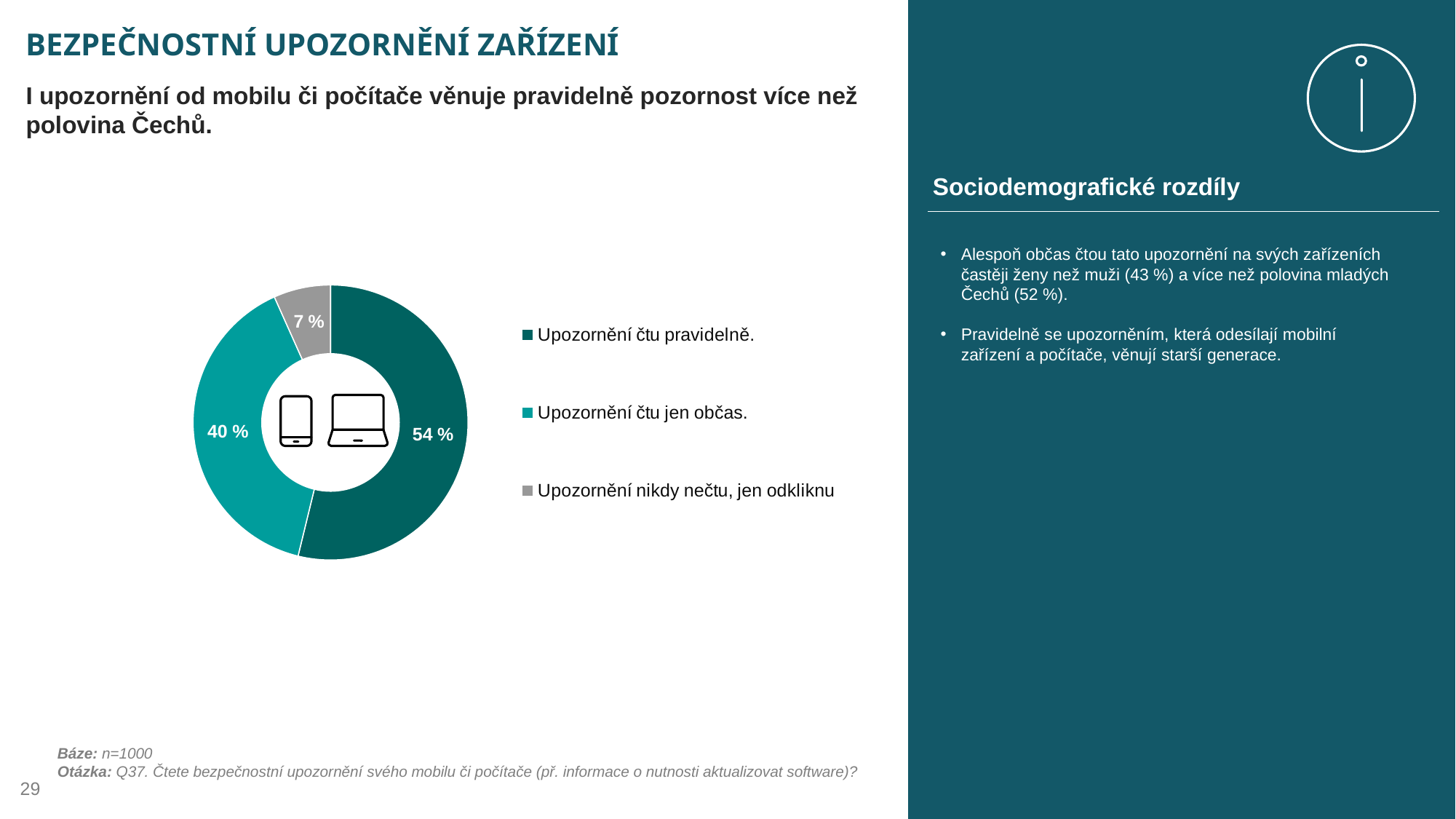
Which category has the smallest slice of the pie? Upozornění nikdy nečtu, jen odkliknu What share of respondents answered "Upozornění nikdy nečtu, jen odkliknu"? 7 % What share of respondents answered "Upozornění čtu jen občas."? 40 % How many slices does the pie chart have? 3 How many entries does the legend list? 3 Which category has the largest slice of the pie? Upozornění čtu pravidelně. What kind of chart is shown on the slide? Pie chart (donut) What is the difference in percentage points between "Upozornění čtu pravidelně." and "Upozornění čtu jen občas."? 14 percentage points What colour is the slice for "Upozornění nikdy nečtu, jen odkliknu"? Grey What is the sample size (base) stated below the chart? n=1000 What share of respondents answered "Upozornění čtu pravidelně."? 54 % Which is larger: the share for "Upozornění čtu jen občas." or for "Upozornění nikdy nečtu, jen odkliknu"? Upozornění čtu jen občas.